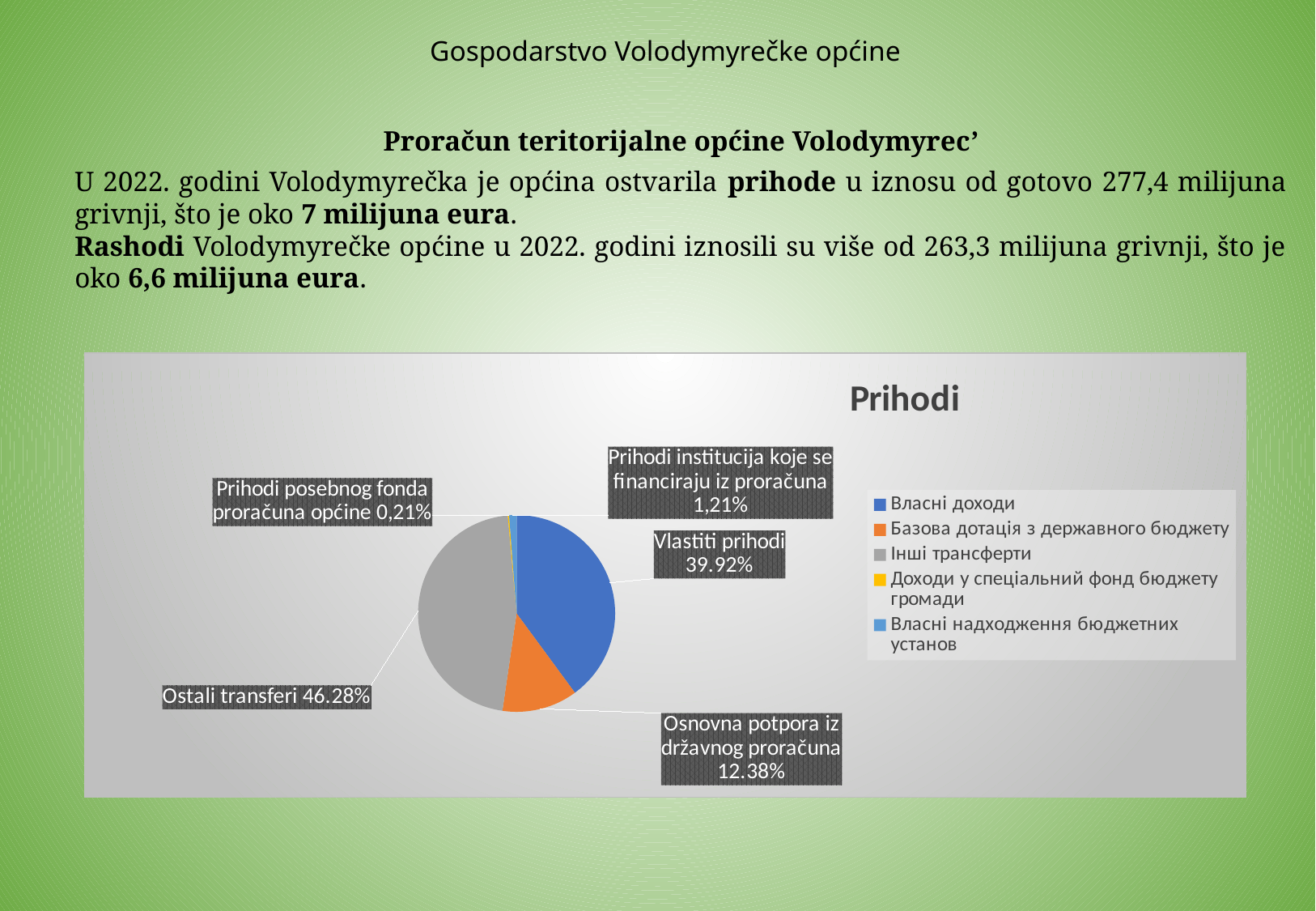
What share of the pie is labelled 'Prihodi institucija koje se financiraju iz proračuna'? 1,21% Which labelled slice has the largest share of the pie? Ostali transferi What share of the pie is labelled 'Ostali transferi'? 46.28% What share of the pie is labelled 'Osnovna potpora iz državnog proračuna'? 12.38% What is the difference between the shares for 'Ostali transferi' and 'Vlastiti prihodi'? 6.36% What is the title of the chart? Prihodi How many slices does the pie chart have? 5 What kind of chart is shown on the slide? pie chart How many entries does the chart legend list? 5 Which labelled slice has the smallest share of the pie? Prihodi posebnog fonda proračuna općine